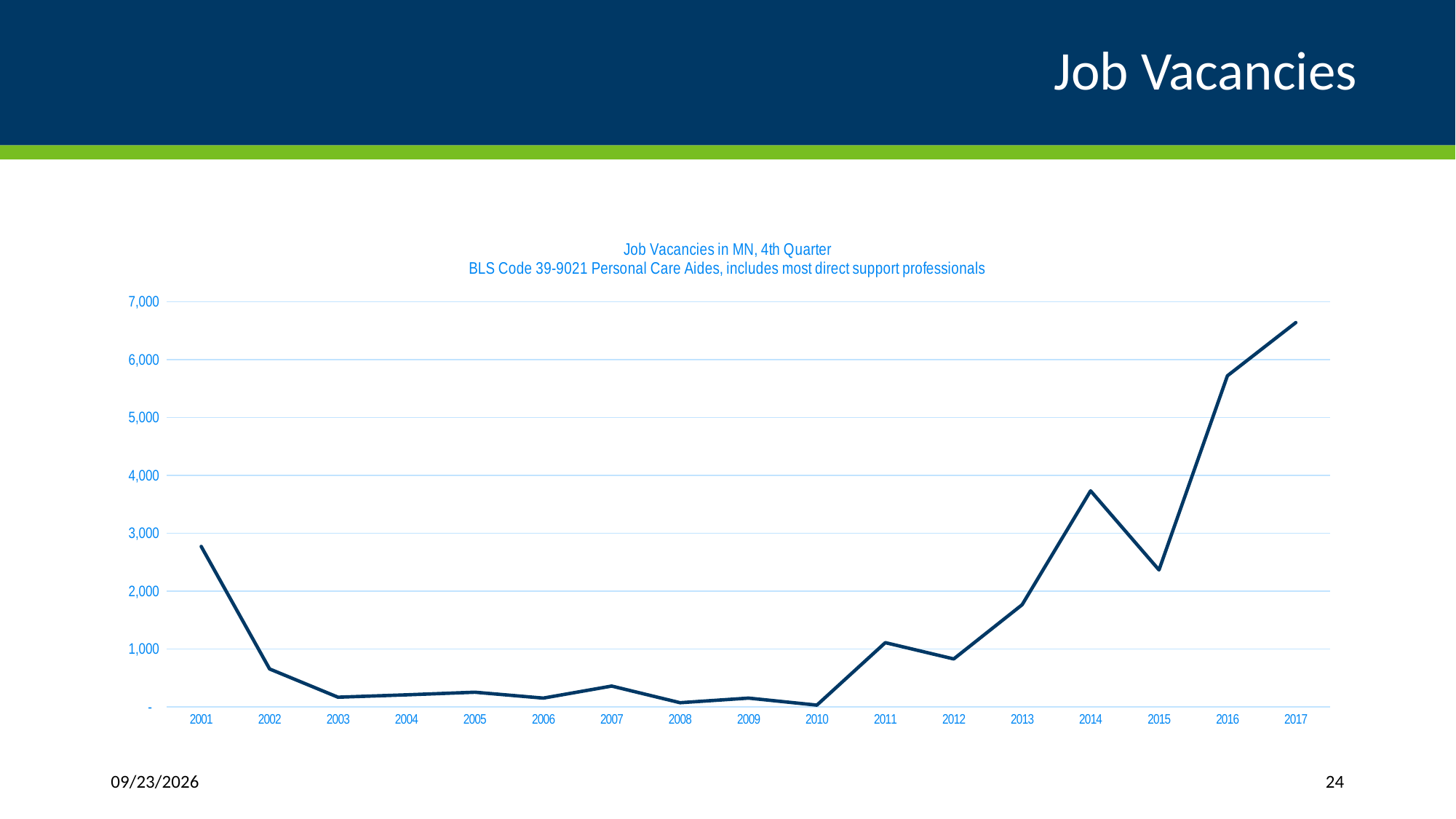
Is the value for 2001 greater or less than 2,000? greater Which year has the highest number of job vacancies in the chart? 2017 How many years are plotted along the x axis of the chart? 17 Is the value for 2010 greater or less than 1,000? less What kind of chart is shown on the slide? line chart Is the value for 2015 greater or less than 3,000? less Do the values rise or fall from 2015 to 2017? rise Which year has the larger value, 2001 or 2002? 2001 Which year has the larger value, 2014 or 2015? 2014 What is the first line of the chart's title? Job Vacancies in MN, 4th Quarter